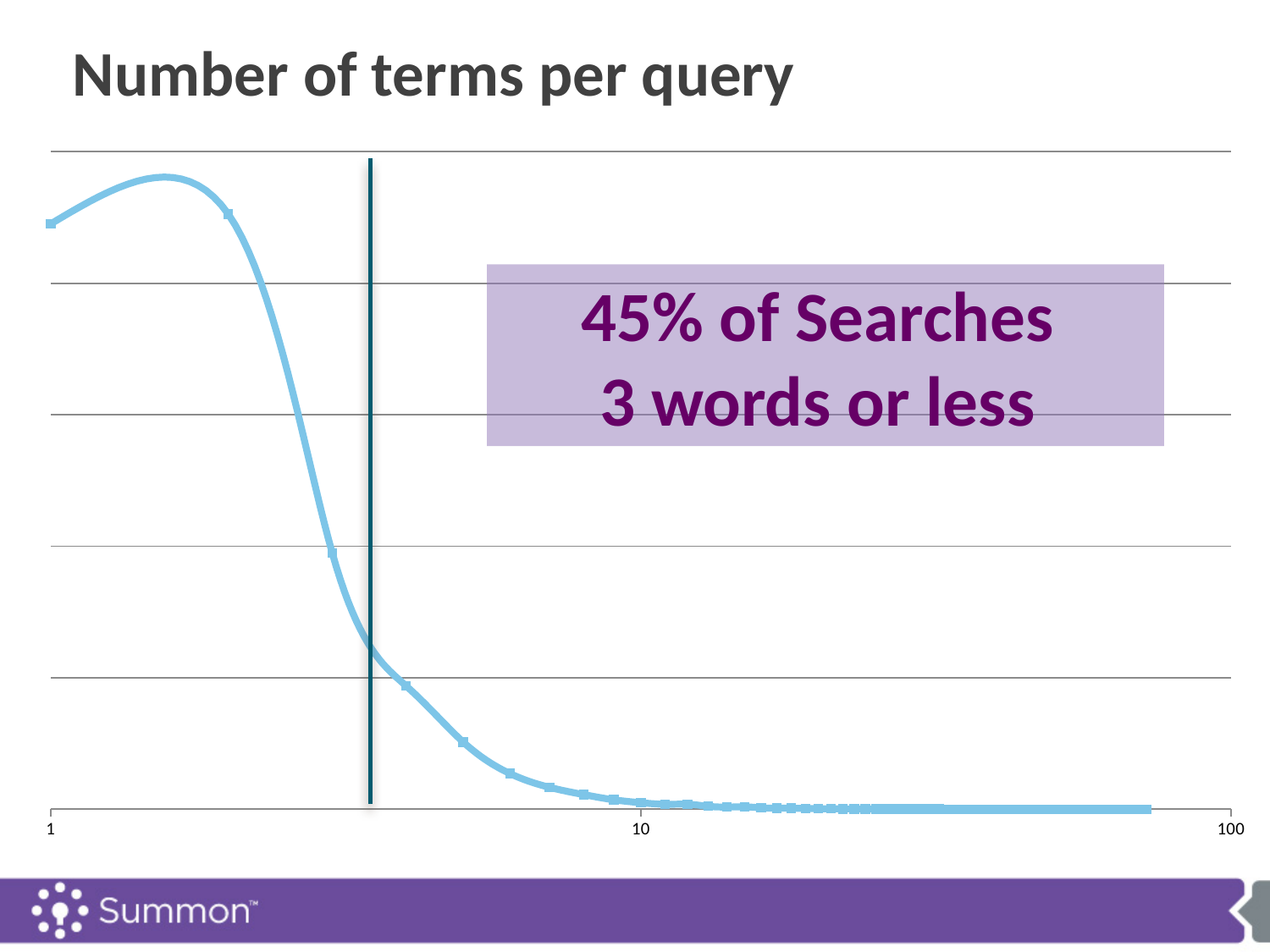
What kind of chart is shown on the slide? line chart Does the line rise or fall between x = 1 and x = 2? rise Is the value of the line at x = 10 higher or lower than its value at x = 1? lower Does the line rise or fall as the x axis moves from 2 toward 10? fall What are the three tick labels shown on the x axis? 1, 10, 100 What is the title of the chart? Number of terms per query